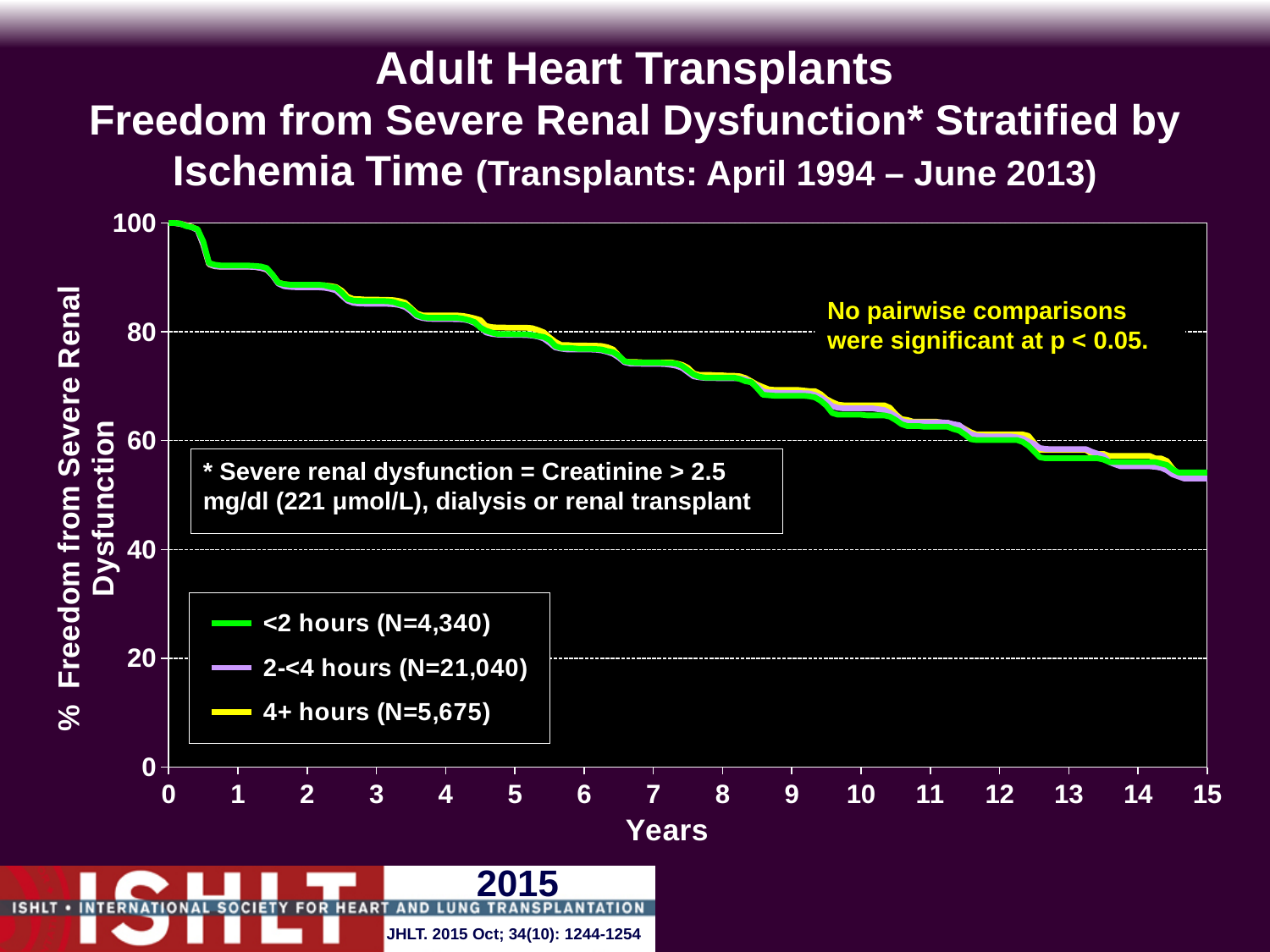
What is the % freedom from severe renal dysfunction for all groups at year 0? 100 How many series does the legend list? 3 Is the value for the 2-<4 hours series at year 15 greater or less than 60? less Is the value for the 4+ hours series at year 10 greater or less than 60? greater Is the value for the 4+ hours series at year 10 greater or less than 80? less What is the label of the x axis? Years What kind of chart is shown on the slide? line chart Which ischemia time group in the legend has the largest N? 2-<4 hours (N=21,040) Do the values for the <2 hours series rise or fall as years increase along the x axis? fall